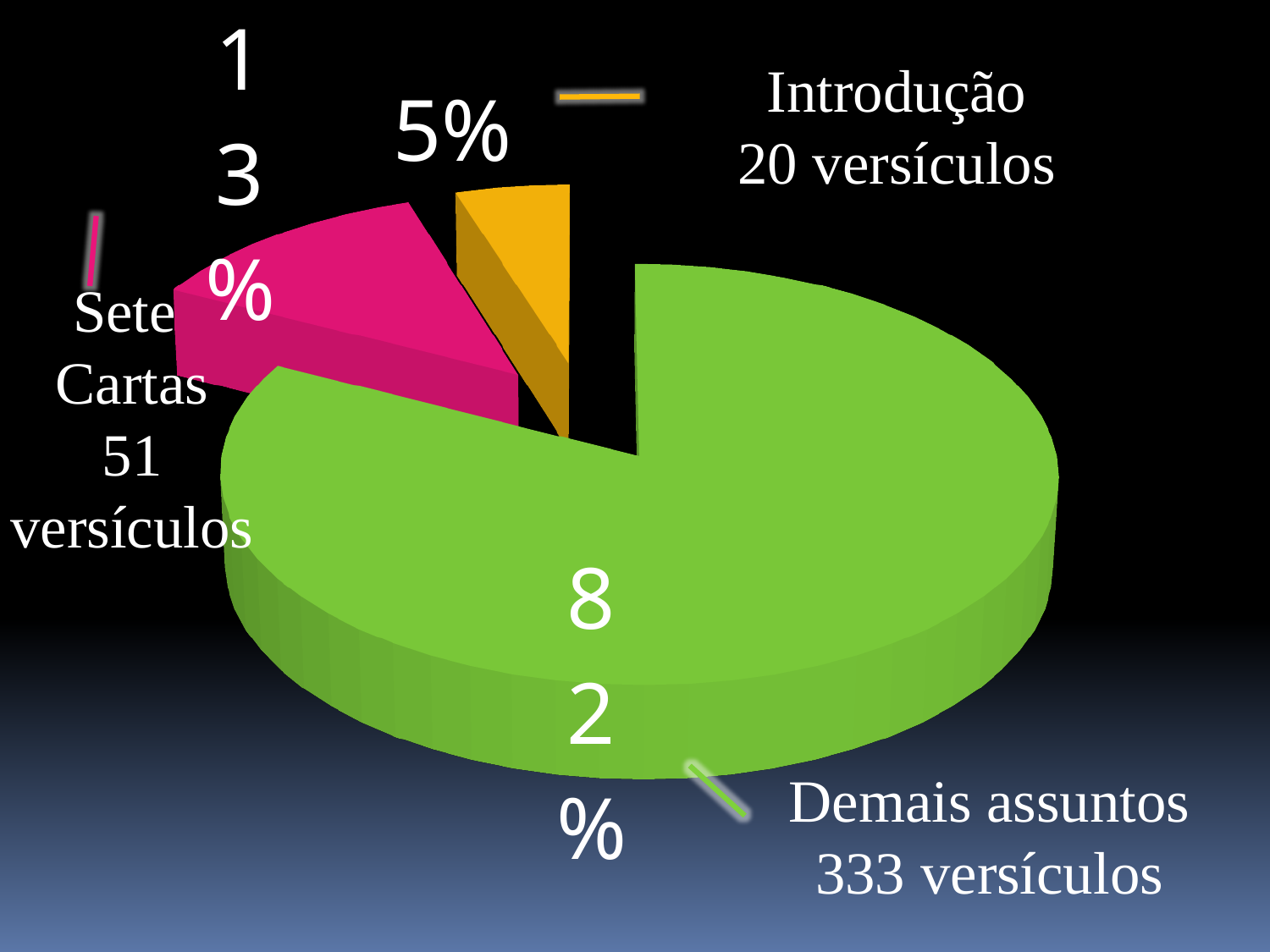
What percentage of the pie does the Sete Cartas slice represent? 13% How many versículos are attributed to Demais assuntos? 333 versículos Which category has the smallest slice of the pie? Introdução How many versículos are attributed to Introdução? 20 versículos Which has more versículos, Sete Cartas or Introdução? Sete Cartas What percentage of the pie does the Introdução slice represent? 5% How many slices does the pie chart have? 3 How many versículos are attributed to Sete Cartas? 51 versículos What percentage of the pie does the Demais assuntos slice represent? 82% What kind of chart is shown on the slide? pie chart What is the difference in versículos between Demais assuntos and Sete Cartas? 282 Which category has the largest slice of the pie? Demais assuntos